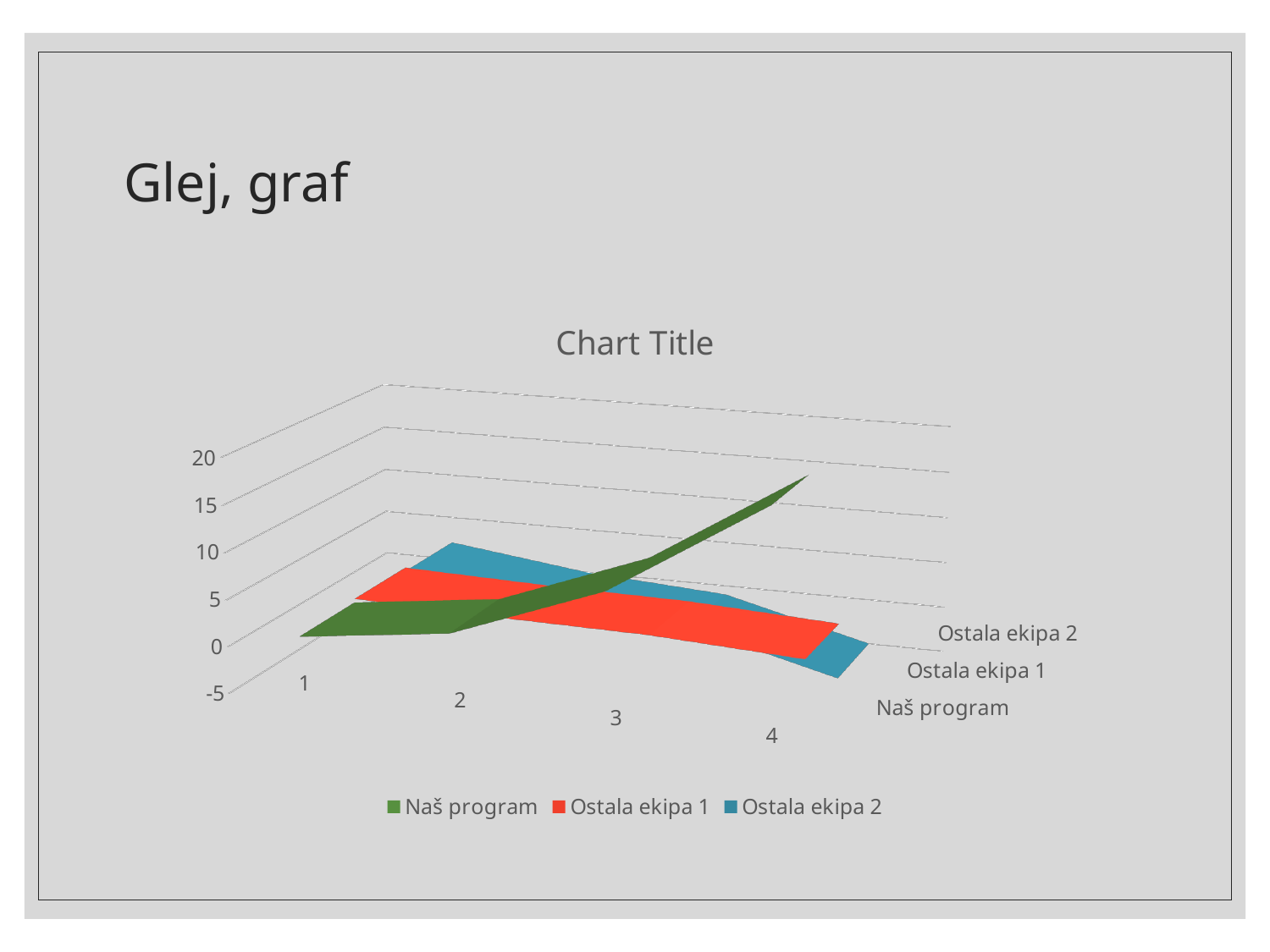
What is the title of the chart? Chart Title How many series does the legend list? 3 What kind of chart is shown on the slide? 3D line chart Which series reaches the highest value on the chart? Naš program What is the highest value shown on the vertical axis? 20 At category 4, which series has the larger value, Naš program or Ostala ekipa 2? Naš program How many categories are shown along the x axis? 4 Do the values for Naš program rise or fall from category 1 to category 4? rise Which series is shown in green in the legend? Naš program Is the value for Naš program at category 4 greater or less than 10? greater Do the values for Ostala ekipa 2 rise or fall from category 1 to category 4? fall Is the value for Naš program at category 1 greater or less than 5? less